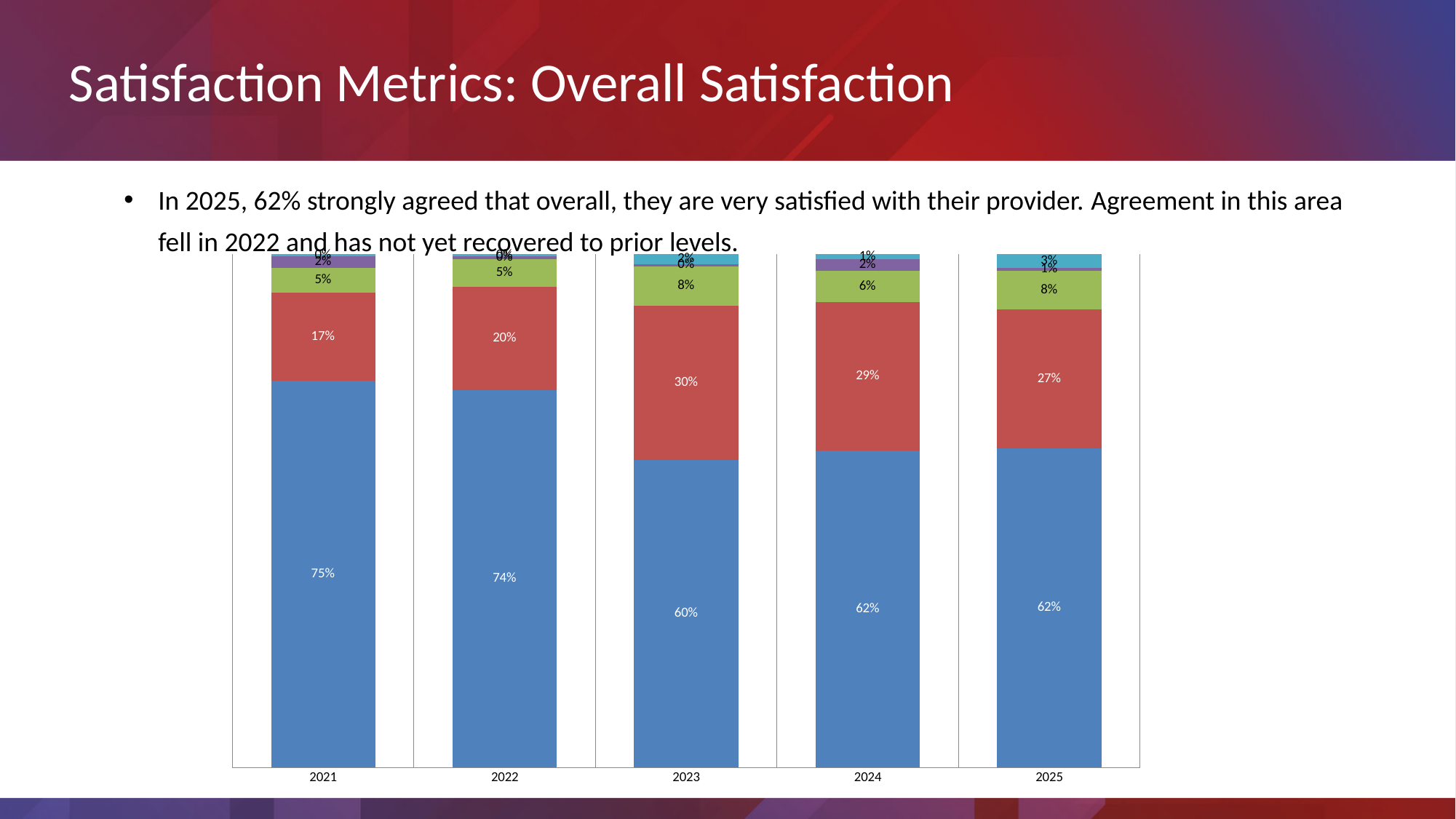
What is the value of the red segment for 2024? 29% Does the blue (bottom) segment rise or fall from 2021 to 2023? fall What is the value of the blue (bottom) segment for 2021? 75% Which year has the highest value for the blue (bottom) segment? 2021 How many years are shown along the x axis of the chart? 5 What kind of chart is shown on the slide? stacked bar chart What is the value of the red segment for 2022? 20% What is the value of the blue (bottom) segment for 2023? 60% What is the difference between the blue segment values for 2021 and 2025? 13% Which year has the lowest value for the blue (bottom) segment? 2023 What is the value of the green segment for 2025? 8% Is the red segment larger for 2023 or for 2021? 2023